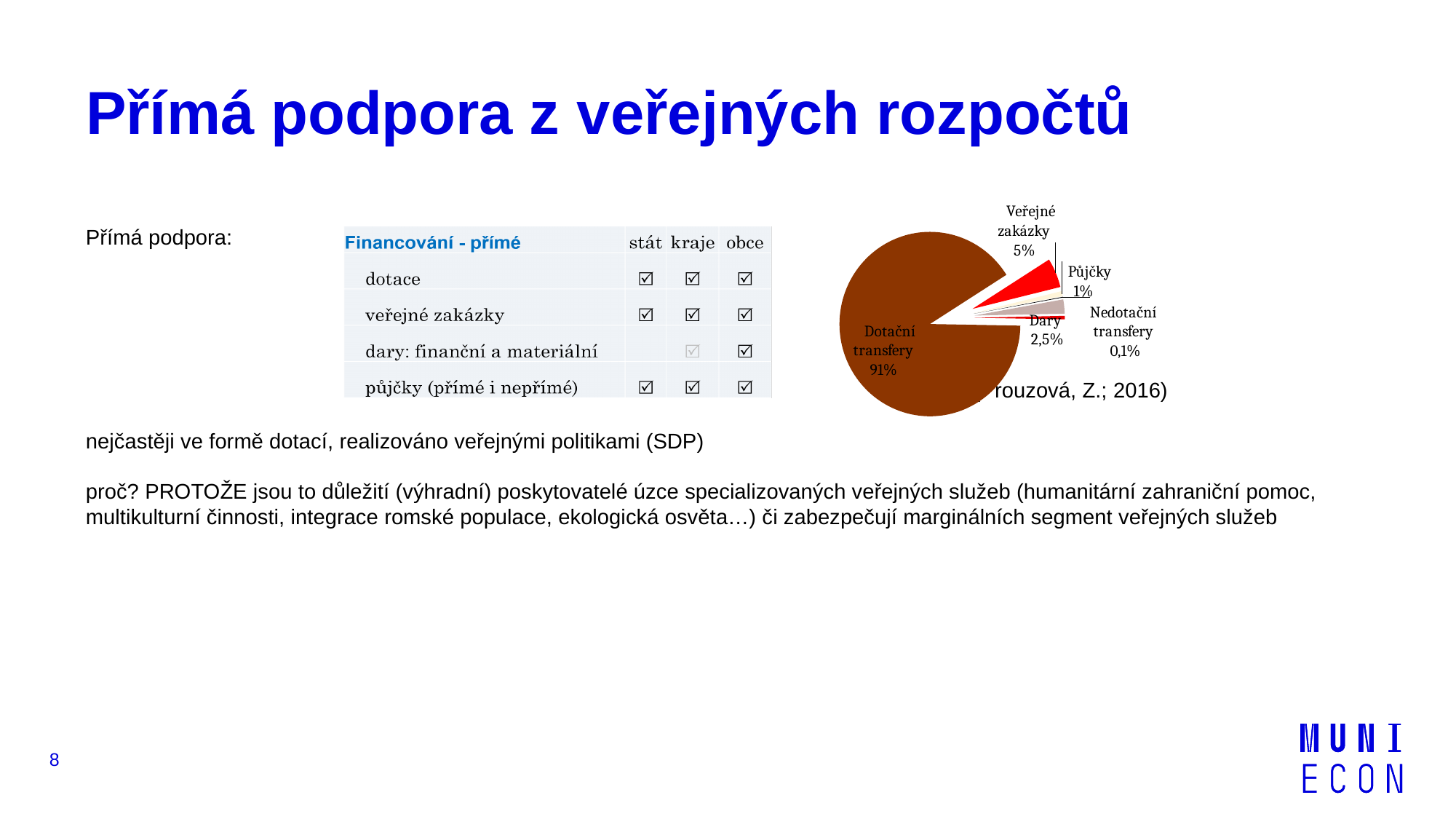
Which slice of the pie chart is the largest? Dotační transfery Which slice of the pie chart is the smallest? Nedotační transfery How many slices does the pie chart have? 6 What is the difference in percentage points between Veřejné zakázky and Dary? 2,5% Which is larger in the pie chart, Dary or Půjčky? Dary What share of the pie does Dary have? 2,5% What share of the pie does Nedotační transfery have? 0,1% What share of the pie does Veřejné zakázky have? 5% What colour is the Dotační transfery slice in the pie chart? brown What kind of chart is shown on the slide? pie chart